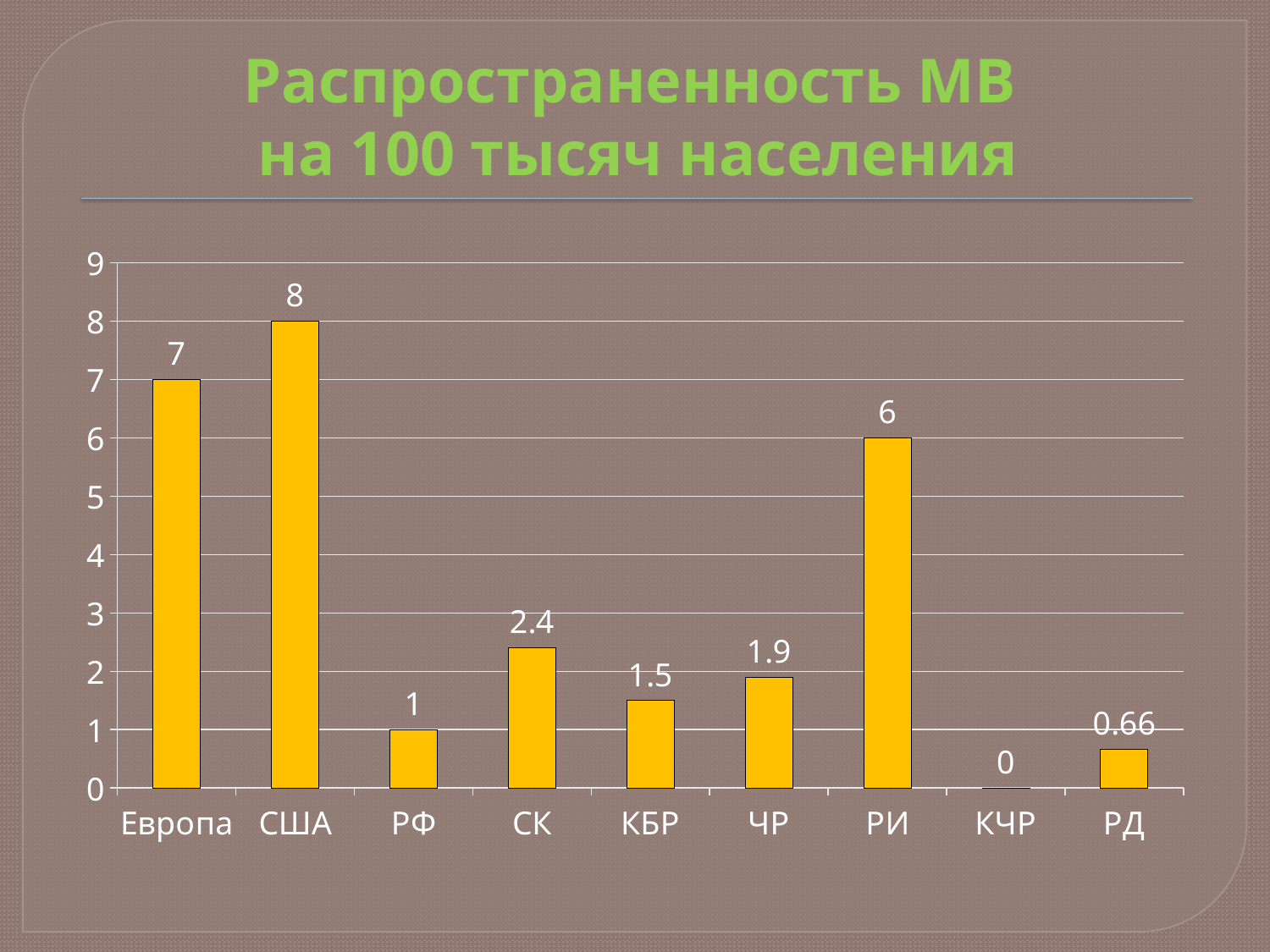
What is the difference between the values for Европа and РИ? 1 What is the value for СК? 2.4 Which is larger, the value for СК or the value for ЧР? СК What is the title of the slide? Распространенность МВ на 100 тысяч населения What is the value for США? 8 How many categories are shown on the x axis? 9 Which category has the highest value? США What colour are the bars in the chart? yellow What is the difference between the values for ЧР and КБР? 0.4 What kind of chart is shown on the slide? bar chart What is the value for РД? 0.66 Which category has the lowest value? КЧР